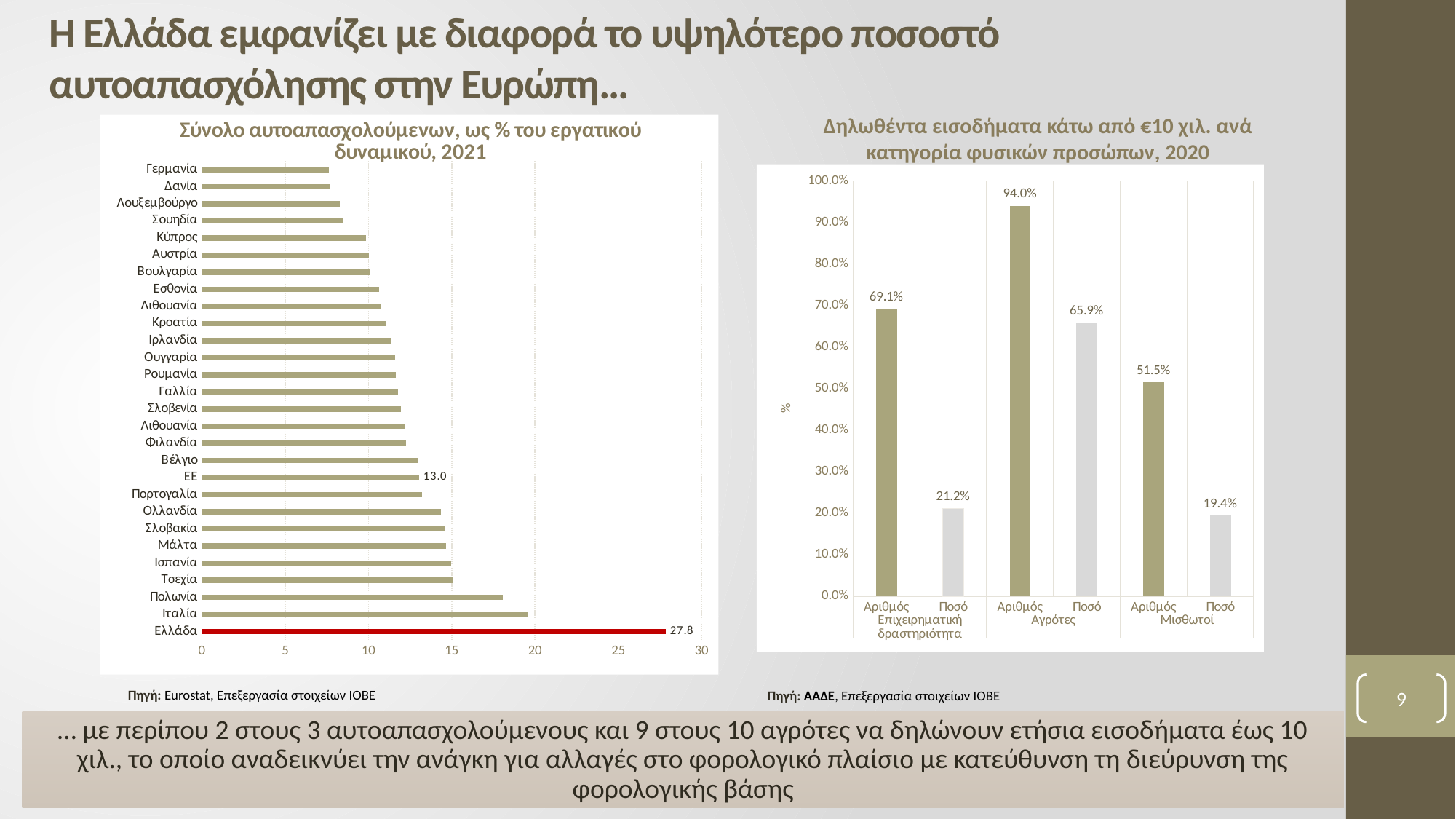
How many categories (bars) are shown in the left chart (Σύνολο αυτοαπασχολούμενων, 2021)? 28 In the right chart (Δηλωθέντα εισοδήματα κάτω από €10 χιλ., 2020), which bar has the lowest value? Ποσό Μισθωτοί (19.4%) In the right chart (Δηλωθέντα εισοδήματα κάτω από €10 χιλ., 2020), what is the value for Αριθμός under Αγρότες? 94.0% In the left chart (Σύνολο αυτοαπασχολούμενων, 2021), is the value for Γερμανία greater or less than 10? less In the left chart (Σύνολο αυτοαπασχολούμενων, 2021), what is the difference between the values for Ελλάδα and ΕΕ? 14.8 In the left chart (Σύνολο αυτοαπασχολούμενων, 2021), is the value for Πολωνία greater or less than 15? greater In the left chart (Σύνολο αυτοαπασχολούμενων, 2021), which country has the lowest value? Γερμανία In the left chart (Σύνολο αυτοαπασχολούμενων, 2021), which country has the highest value? Ελλάδα In the right chart (Δηλωθέντα εισοδήματα κάτω από €10 χιλ., 2020), what is the difference between Αριθμός and Ποσό for Αγρότες? 28.1 percentage points In the left chart (Σύνολο αυτοαπασχολούμενων, 2021), what is the value for ΕΕ? 13.0 What kind of chart is the left chart (Σύνολο αυτοαπασχολούμενων, 2021)? Bar chart In the left chart (Σύνολο αυτοαπασχολούμενων, ως % του εργατικού δυναμικού, 2021), what is the value for Ελλάδα? 27.8